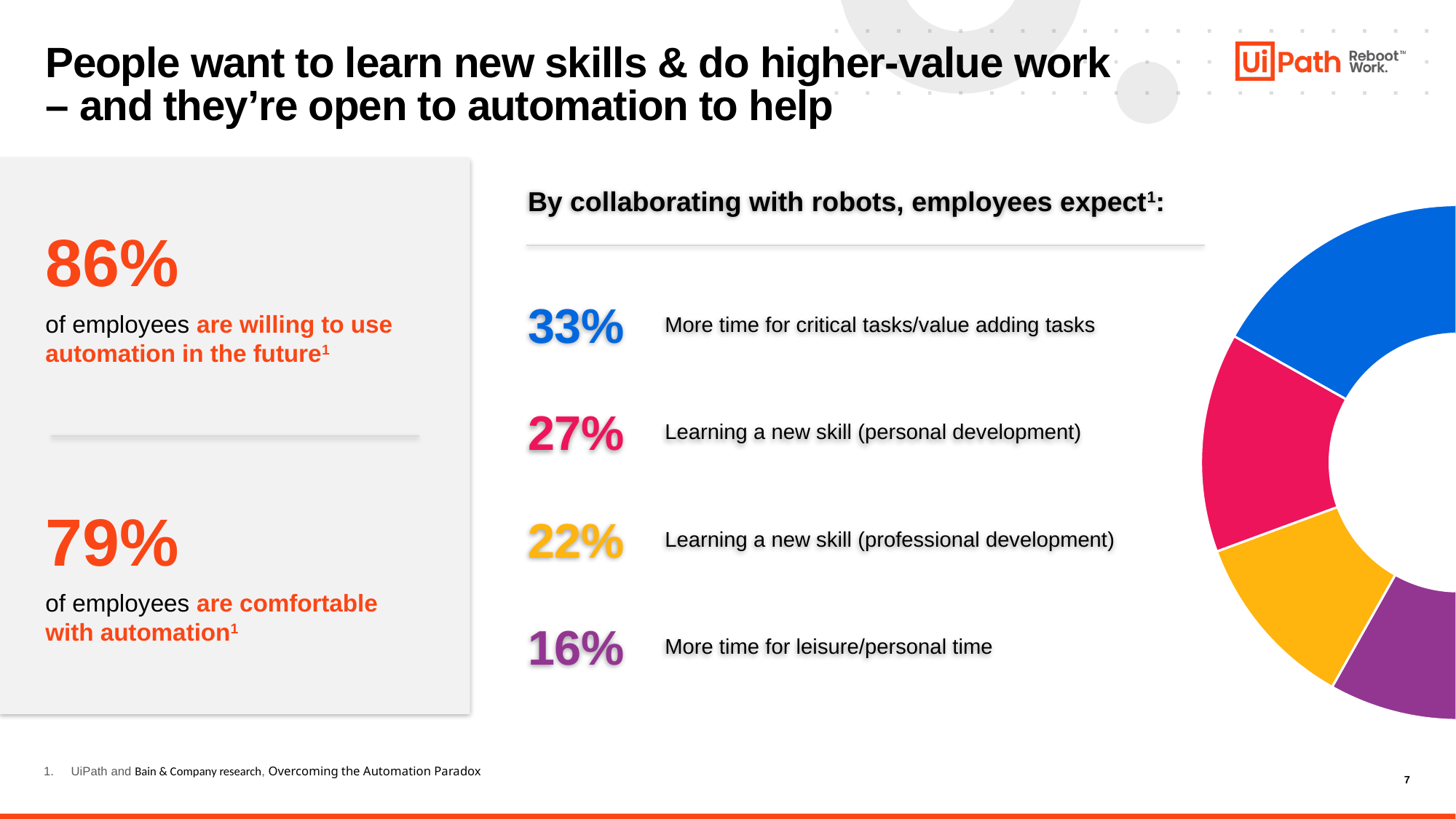
What colour is the segment representing more time for critical tasks/value adding tasks? Blue What kind of chart is shown on the right side of the slide? Donut chart Which expectation has the highest percentage in the donut chart? More time for critical tasks/value adding tasks What percentage of employees expect more time for critical tasks/value adding tasks by collaborating with robots? 33% What percentage of employees expect learning a new skill (personal development)? 27% What percentage of employees expect learning a new skill (professional development)? 22% How many segments does the donut chart have? 4 Which expectation has the lowest percentage in the donut chart? More time for leisure/personal time What is the difference between the percentage for more time for critical tasks/value adding tasks and the percentage for more time for leisure/personal time? 17% Which is larger: the percentage for learning a new skill (personal development) or learning a new skill (professional development)? Learning a new skill (personal development) What percentage of employees expect more time for leisure/personal time? 16% What colour is the segment representing more time for leisure/personal time? Purple